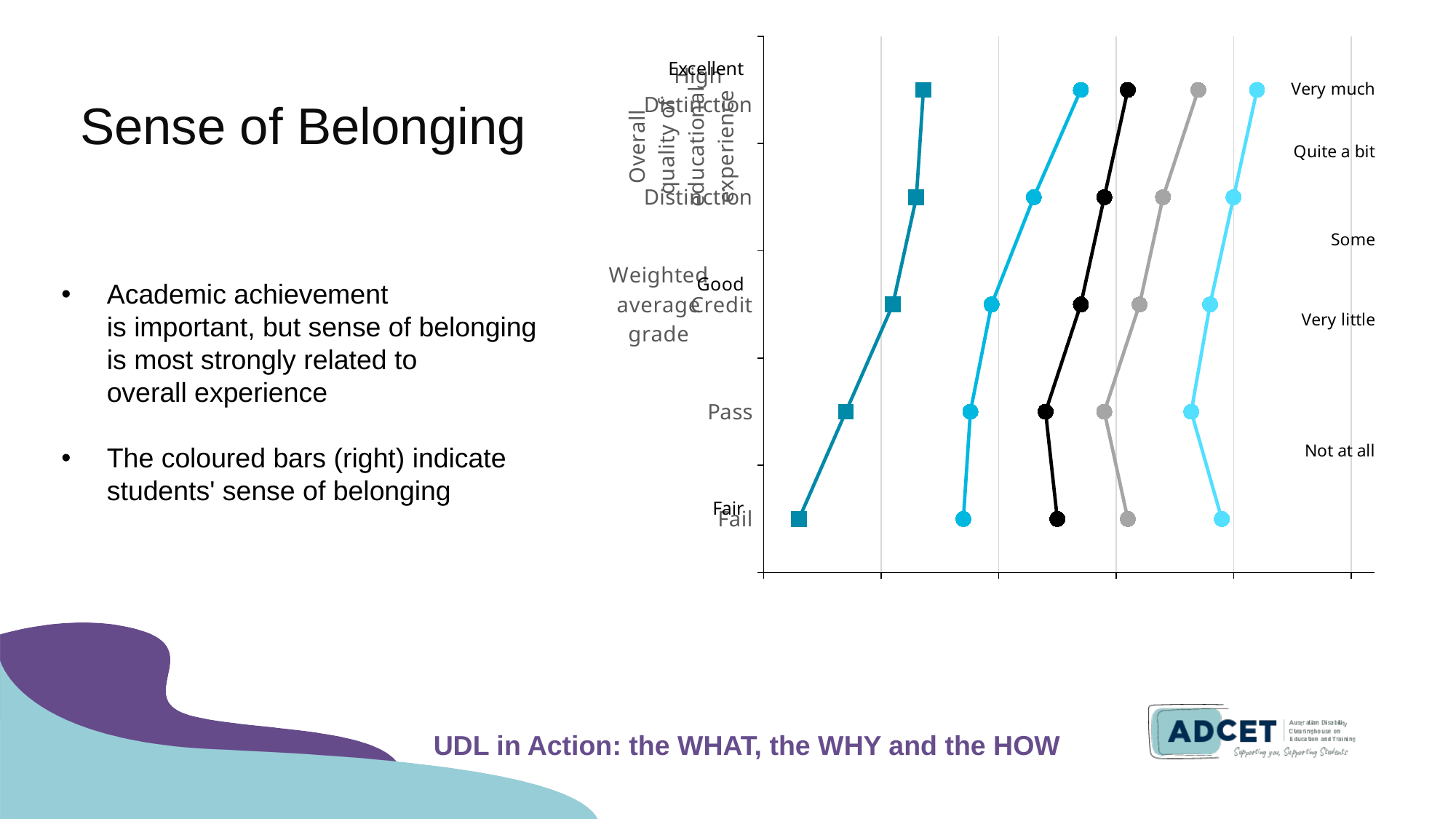
What is the bottom label on the right-hand side of the chart? Not at all Moving up the chart from Fail to High Distinction, does the grey line shift to the right or to the left? right What kind of chart is shown on the slide? line chart What is the topmost label on the right-hand side of the chart? Very much How many lines are plotted on the chart? 5 How many labels are listed down the right-hand side of the chart (from "Very much" to "Not at all")? 5 Moving up the chart from Fail to High Distinction, does the dark teal line with square markers shift to the right or to the left? right Moving up the chart from Fail to High Distinction, does the black line shift to the right or to the left? right Which is further to the right at the Fail level: the dark teal square marker or the black point? the black point Which is further to the right at the Pass level: the black line's point or the grey line's point? the grey line's point